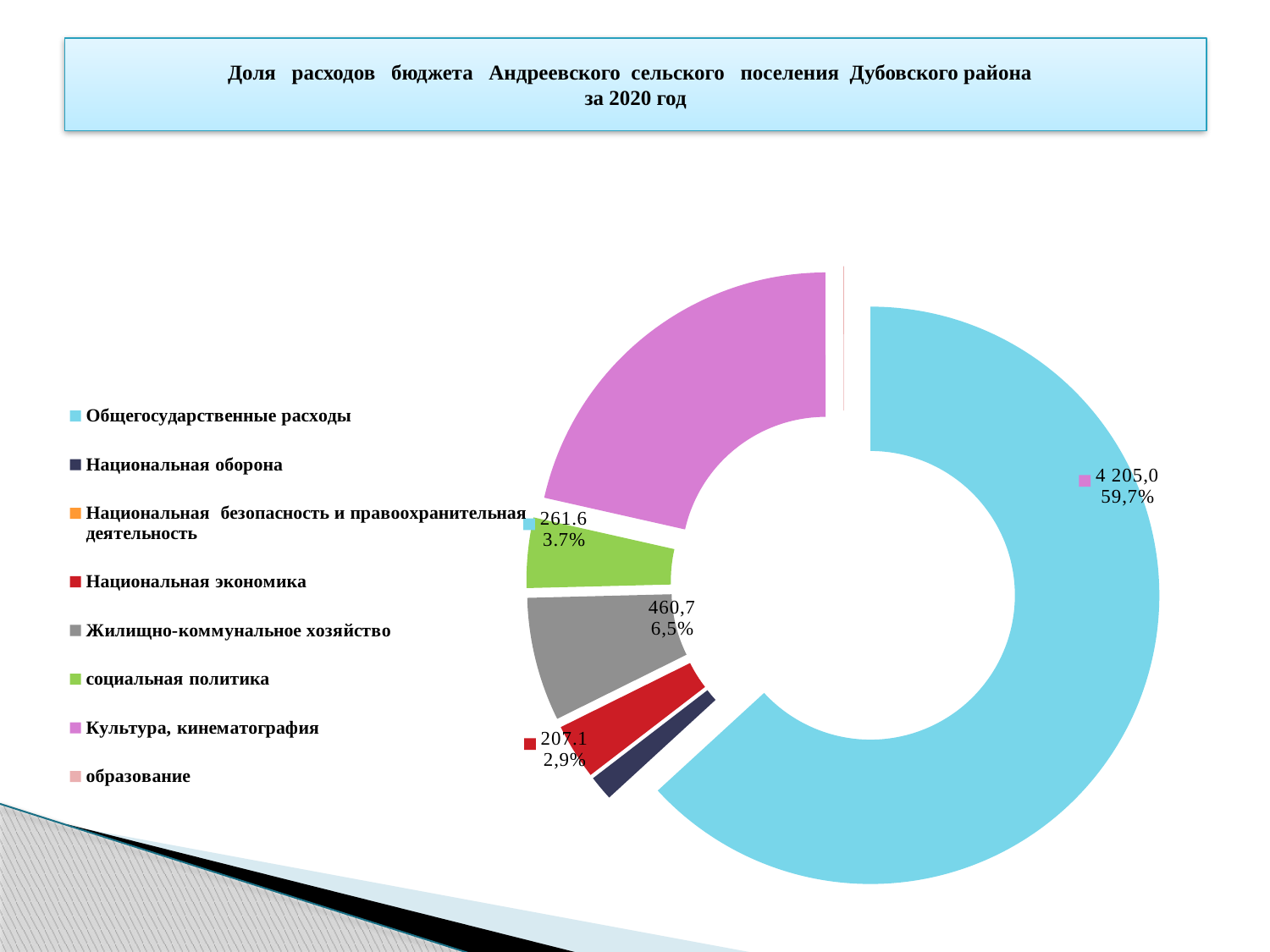
What percentage is shown next to the value 460,7? 6,5% Which is larger: the slice for Общегосударственные расходы or the slice for Культура, кинематография? Общегосударственные расходы What year does the chart title say the budget expenditure shares are for? 2020 What percentage is shown next to the value 207.1? 2,9% Which category has the largest share of the budget expenditures? Общегосударственные расходы Which is larger: the slice for Культура, кинематография or the slice for Жилищно-коммунальное хозяйство? Культура, кинематография What percentage share is labelled on the largest slice? 59,7% What value is labelled on the largest slice of the chart? 4 205,0 How many categories does the legend list? 8 What kind of chart is shown on the slide? Pie (doughnut) chart Which is larger: the slice for Жилищно-коммунальное хозяйство or the slice for Национальная экономика? Жилищно-коммунальное хозяйство What colour is the slice for Общегосударственные расходы? Light blue